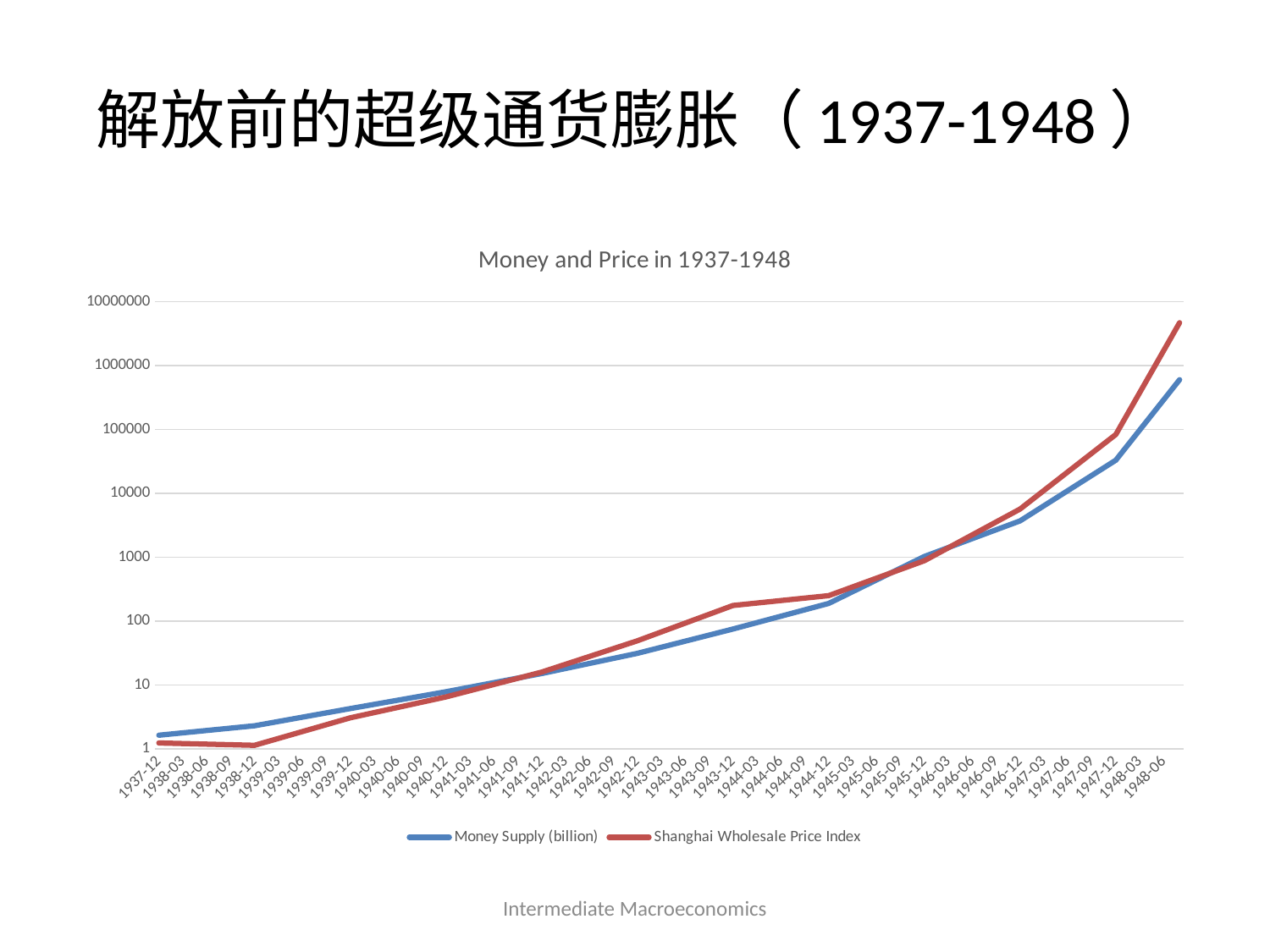
Is the value of Money Supply (billion) at 1947-12 greater or less than 10000? greater How many time points are labelled on the x axis? 43 Do the values of the Shanghai Wholesale Price Index rise or fall from 1937-12 to 1948-06? rise What is the title of the chart? Money and Price in 1937-1948 At 1948-06, which series has the higher value, Money Supply (billion) or Shanghai Wholesale Price Index? Shanghai Wholesale Price Index Is the value of the Shanghai Wholesale Price Index at 1948-06 greater or less than 1000000? greater Which series is drawn in red? Shanghai Wholesale Price Index Is the value of Money Supply (billion) at 1948-06 greater or less than 1000000? less At 1938-12, which series has the higher value, Money Supply (billion) or Shanghai Wholesale Price Index? Money Supply (billion) What kind of chart is shown on the slide? line chart How many series does the legend list? 2